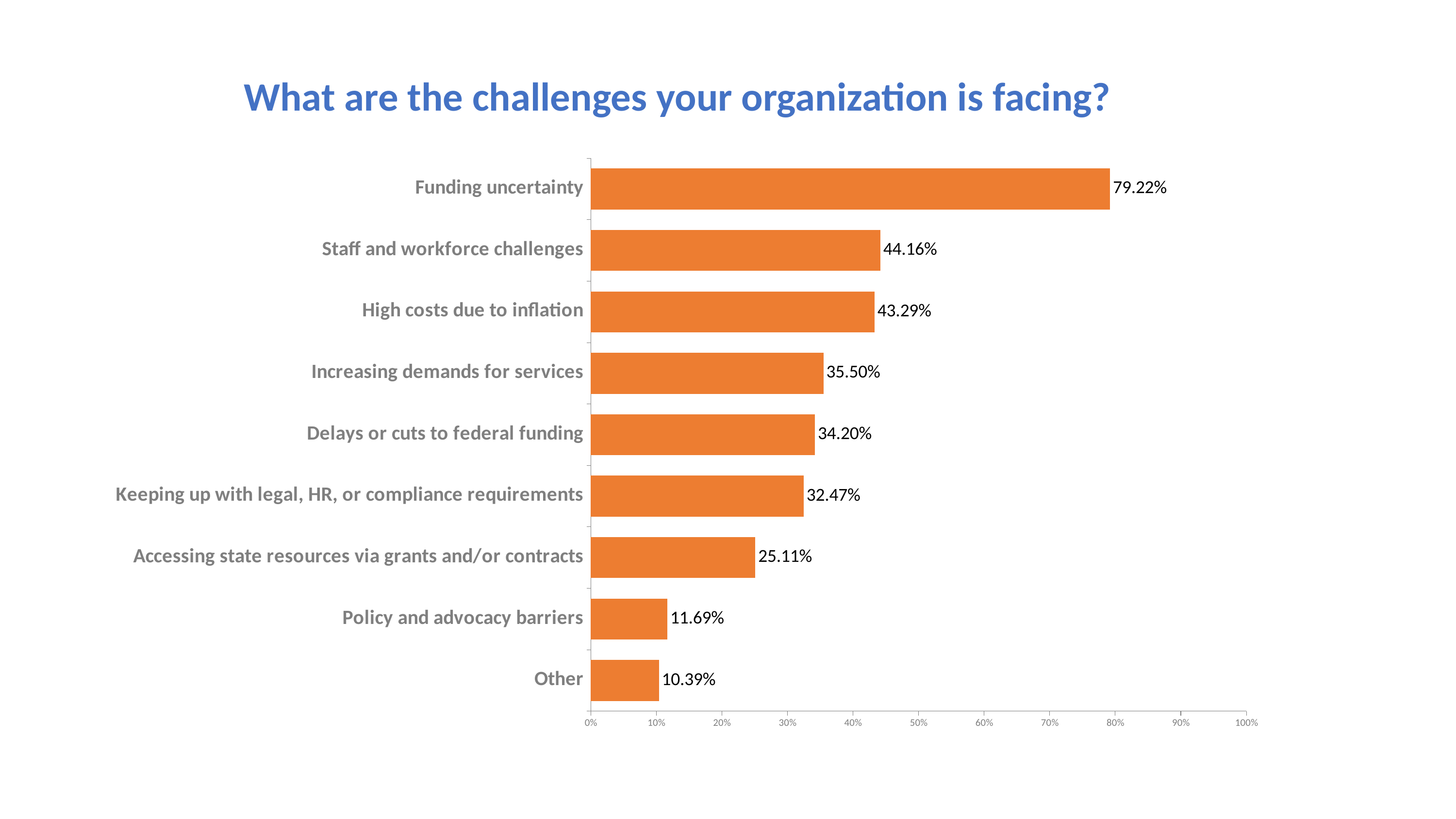
Is the value for Delays or cuts to federal funding greater or less than 30%? greater What is the difference between Increasing demands for services and Delays or cuts to federal funding? 1.30% How many challenge categories are shown in the chart? 9 What percentage of organizations reported Funding uncertainty as a challenge? 79.22% Which is larger: High costs due to inflation or Keeping up with legal, HR, or compliance requirements? High costs due to inflation Which category has the lowest percentage? Other What is the value for Staff and workforce challenges? 44.16% What type of chart is shown on the slide? Bar chart What is the difference between Funding uncertainty and Staff and workforce challenges? 35.06% What is the value for Policy and advocacy barriers? 11.69% What is the value for Accessing state resources via grants and/or contracts? 25.11% Which challenge has the highest percentage? Funding uncertainty